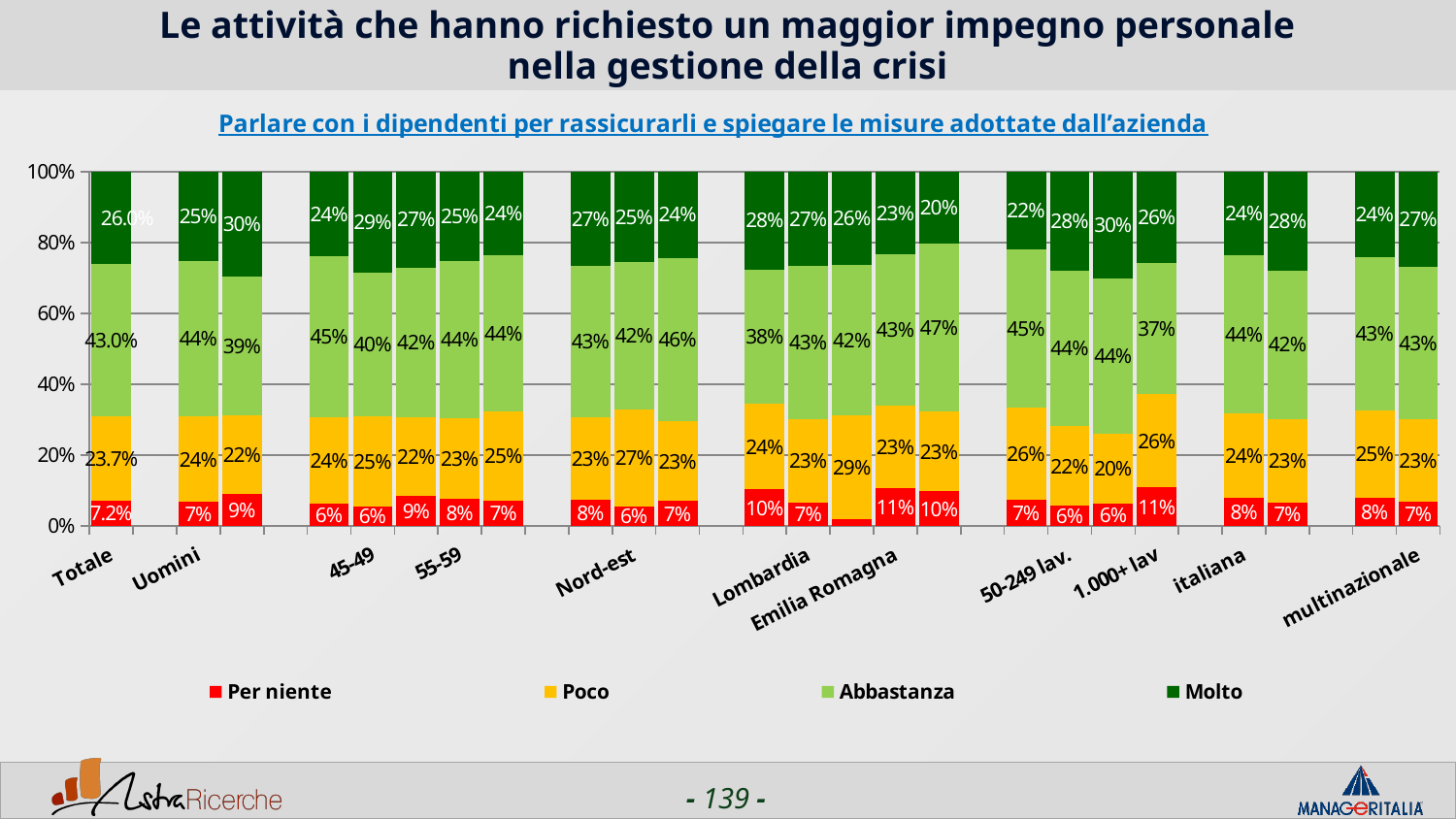
What is the 'Poco' value for Totale? 23.7% What is the 'Abbastanza' value for Uomini? 44% What are the four legend entries of the chart? Per niente, Poco, Abbastanza, Molto How many series does the legend list? 4 What kind of chart is shown on the slide? Stacked bar chart What is the difference between the 'Abbastanza' and 'Molto' values for Uomini? 19% What is the 'Per niente' value for multinazionale (the last bar)? 7% What is the 'Molto' value for Totale? 26.0% What is the 'Per niente' value for Totale? 7.2% What is the 'Abbastanza' value for Totale? 43.0% For Uomini, which is larger: the 'Poco' value or the 'Per niente' value? Poco What is the 'Molto' value for Uomini? 25%